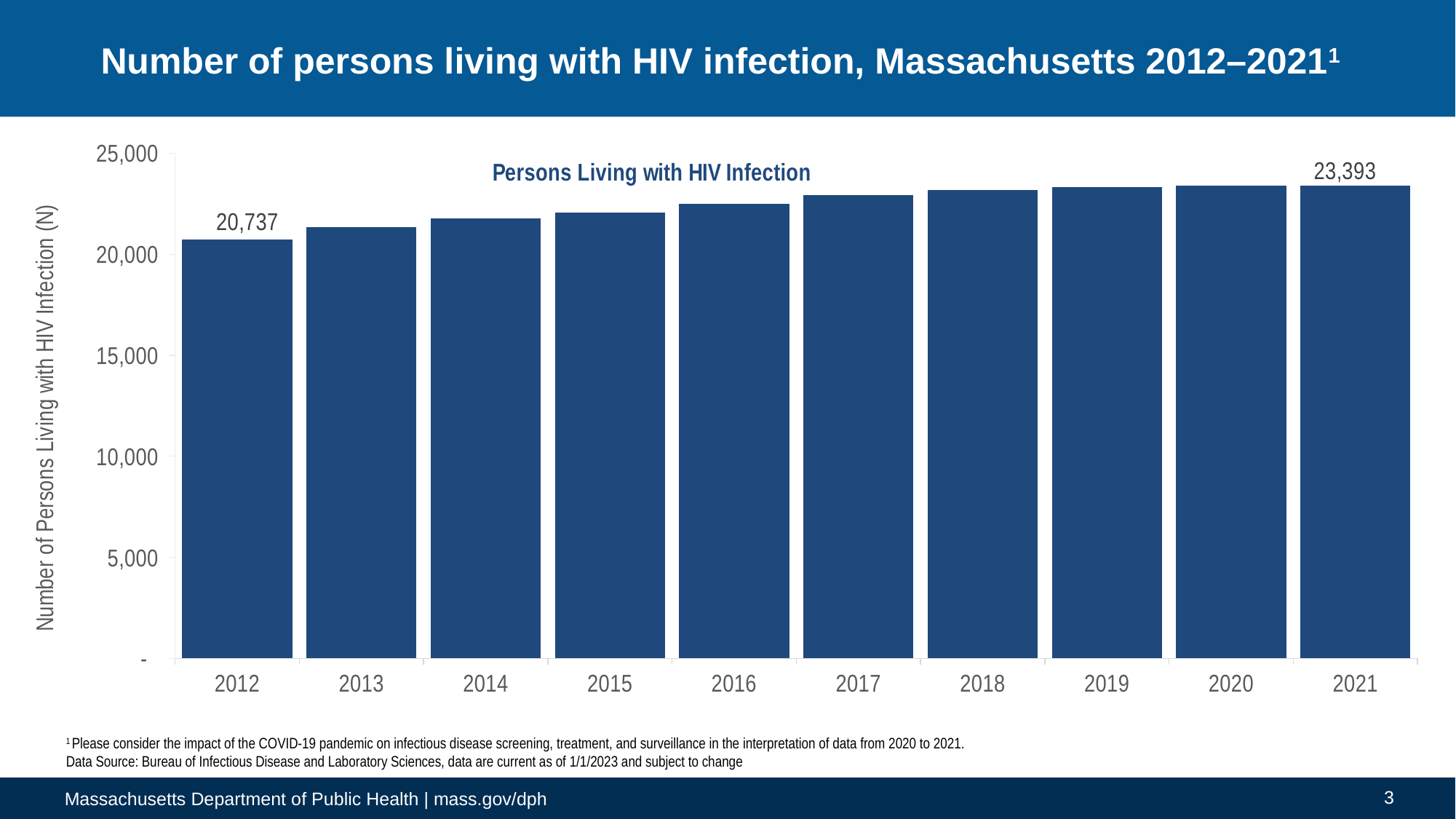
Which year has a larger number of persons living with HIV infection, 2013 or 2019? 2019 What is the label on the vertical axis of the chart? Number of Persons Living with HIV Infection (N) Do the values rise or fall from 2012 to 2021? Rise What is the number of persons living with HIV infection in 2012? 20,737 How many years are shown on the x axis of the chart? 10 Is the value for 2016 greater or less than 20,000? greater What is the difference between the number of persons living with HIV infection in 2021 and in 2012? 2,656 What is the number of persons living with HIV infection in 2021? 23,393 Is the value for 2018 greater or less than 25,000? less What kind of chart is shown on the slide? Bar chart Which year has the lowest number of persons living with HIV infection? 2012